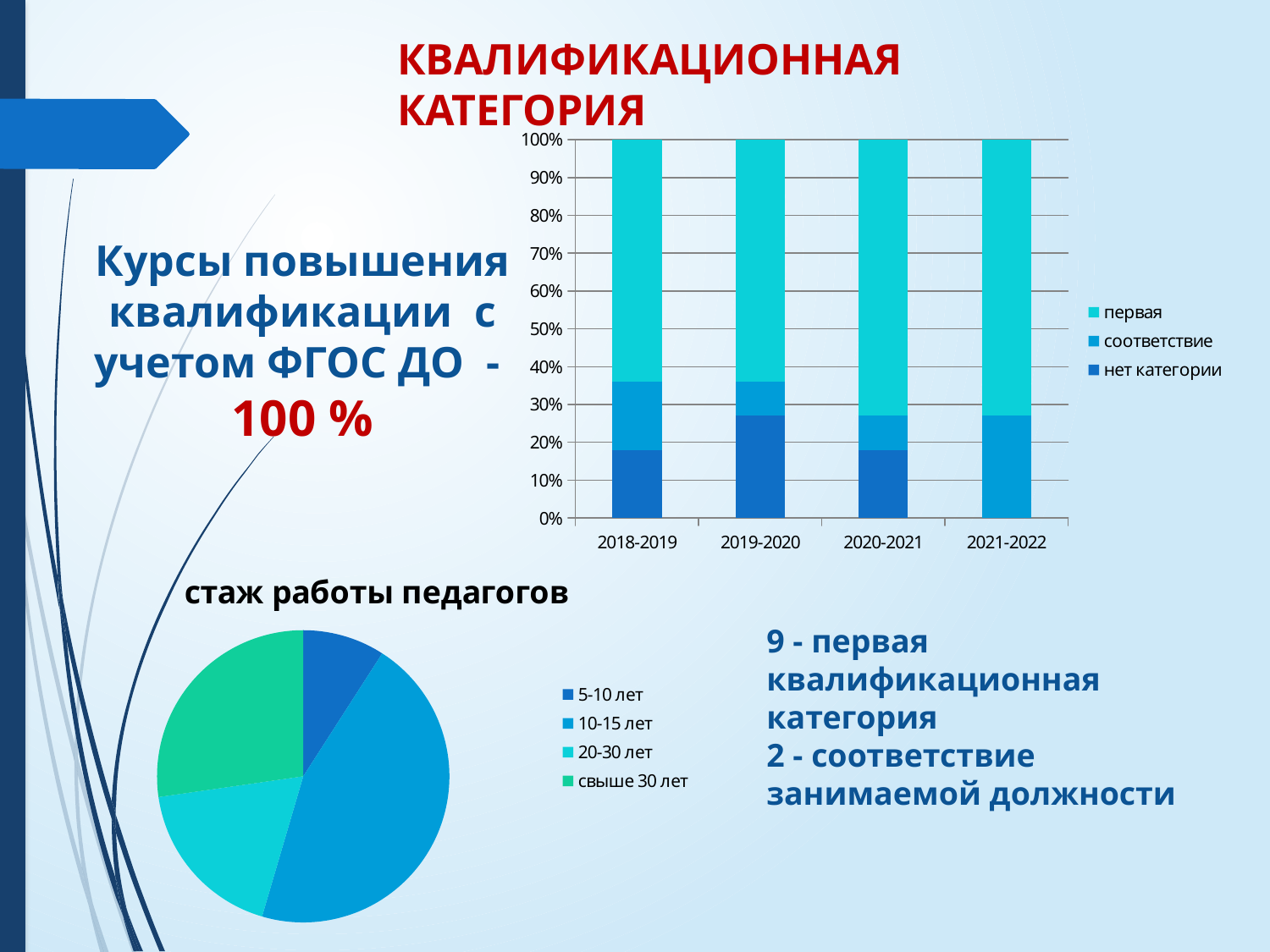
Which series is listed first in the legend of the 'КВАЛИФИКАЦИОННАЯ КАТЕГОРИЯ' chart? первая How many year categories are shown on the x axis of the 'КВАЛИФИКАЦИОННАЯ КАТЕГОРИЯ' chart? 4 What kind of chart is the chart titled 'КВАЛИФИКАЦИОННАЯ КАТЕГОРИЯ'? Stacked bar chart In the 'КВАЛИФИКАЦИОННАЯ КАТЕГОРИЯ' chart, is the value for 'нет категории' in 2019-2020 greater or less than 20%? greater In the 'КВАЛИФИКАЦИОННАЯ КАТЕГОРИЯ' chart, which is larger: 'нет категории' in 2018-2019 or 'нет категории' in 2021-2022? 2018-2019 In the 'стаж работы педагогов' pie chart, which category has the largest slice? 10-15 лет How many slices does the 'стаж работы педагогов' pie chart have? 4 How many series does the legend of the 'КВАЛИФИКАЦИОННАЯ КАТЕГОРИЯ' chart list? 3 In the 'стаж работы педагогов' pie chart, which category has the smallest slice? 5-10 лет What kind of chart is the chart titled 'стаж работы педагогов'? Pie chart In the 'КВАЛИФИКАЦИОННАЯ КАТЕГОРИЯ' chart, is the value for 'первая' in 2018-2019 greater or less than 60%? greater In the 'КВАЛИФИКАЦИОННАЯ КАТЕГОРИЯ' chart, is the value for 'нет категории' in 2018-2019 greater or less than 20%? less